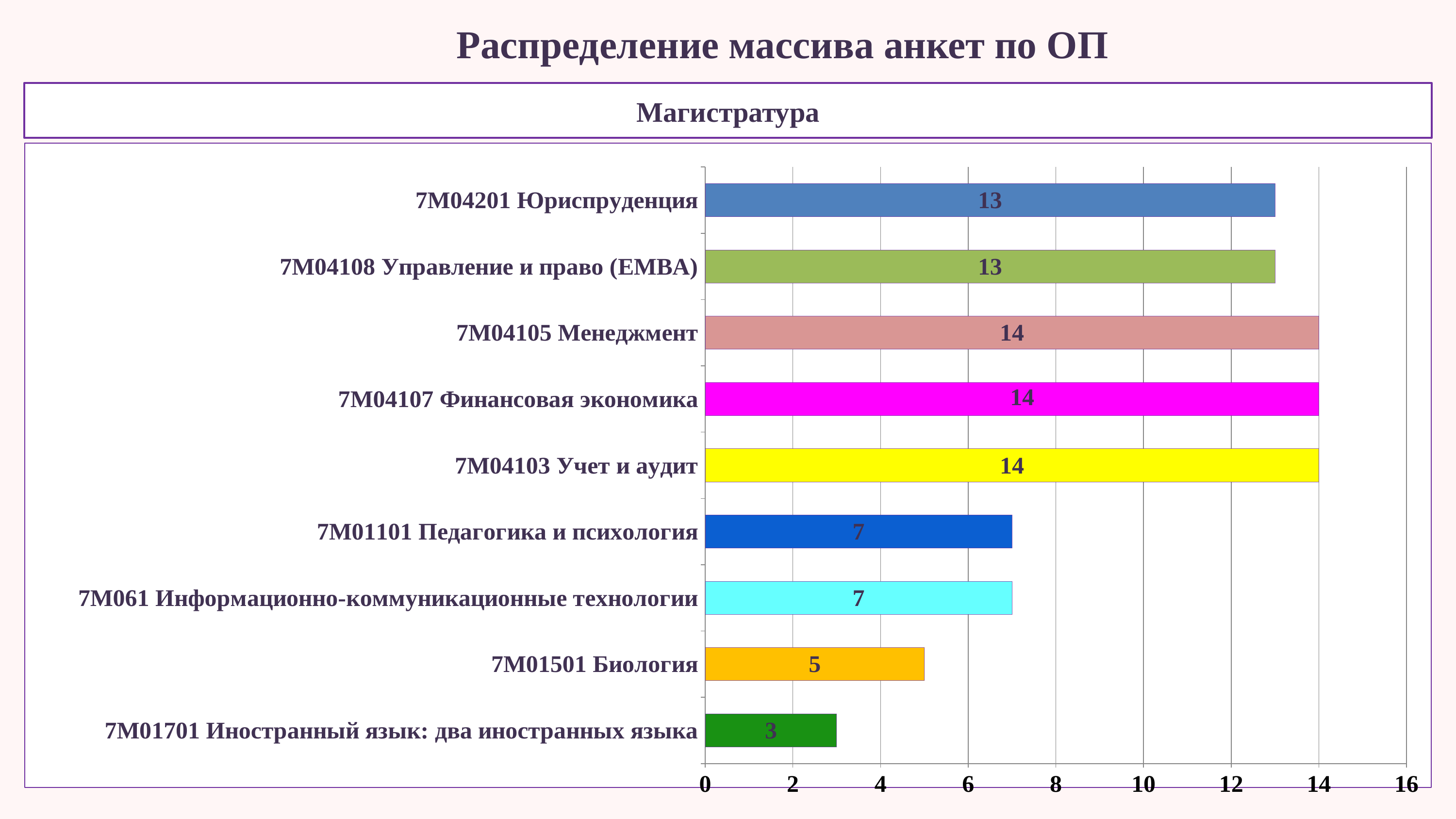
What is the value for 7M01501 Биология? 5 What is the difference between the values for 7M01501 Биология and 7M01701 Иностранный язык: два иностранных языка? 2 What is the highest value shown on the x axis? 16 What is the value for 7M061 Информационно-коммуникационные технологии? 7 Which is larger, the value for 7M04108 Управление и право (EMBA) or the value for 7M01501 Биология? 7M04108 Управление и право (EMBA) What kind of chart is shown on the slide? bar chart What is the difference between the values for 7M04105 Менеджмент and 7M01101 Педагогика и психология? 7 What is the title of the slide? Распределение массива анкет по ОП What is the value for 7M04201 Юриспруденция? 13 How many categories are shown in the chart? 9 Which category has the lowest value? 7M01701 Иностранный язык: два иностранных языка Is the value for 7M04103 Учет и аудит greater or less than 10? greater